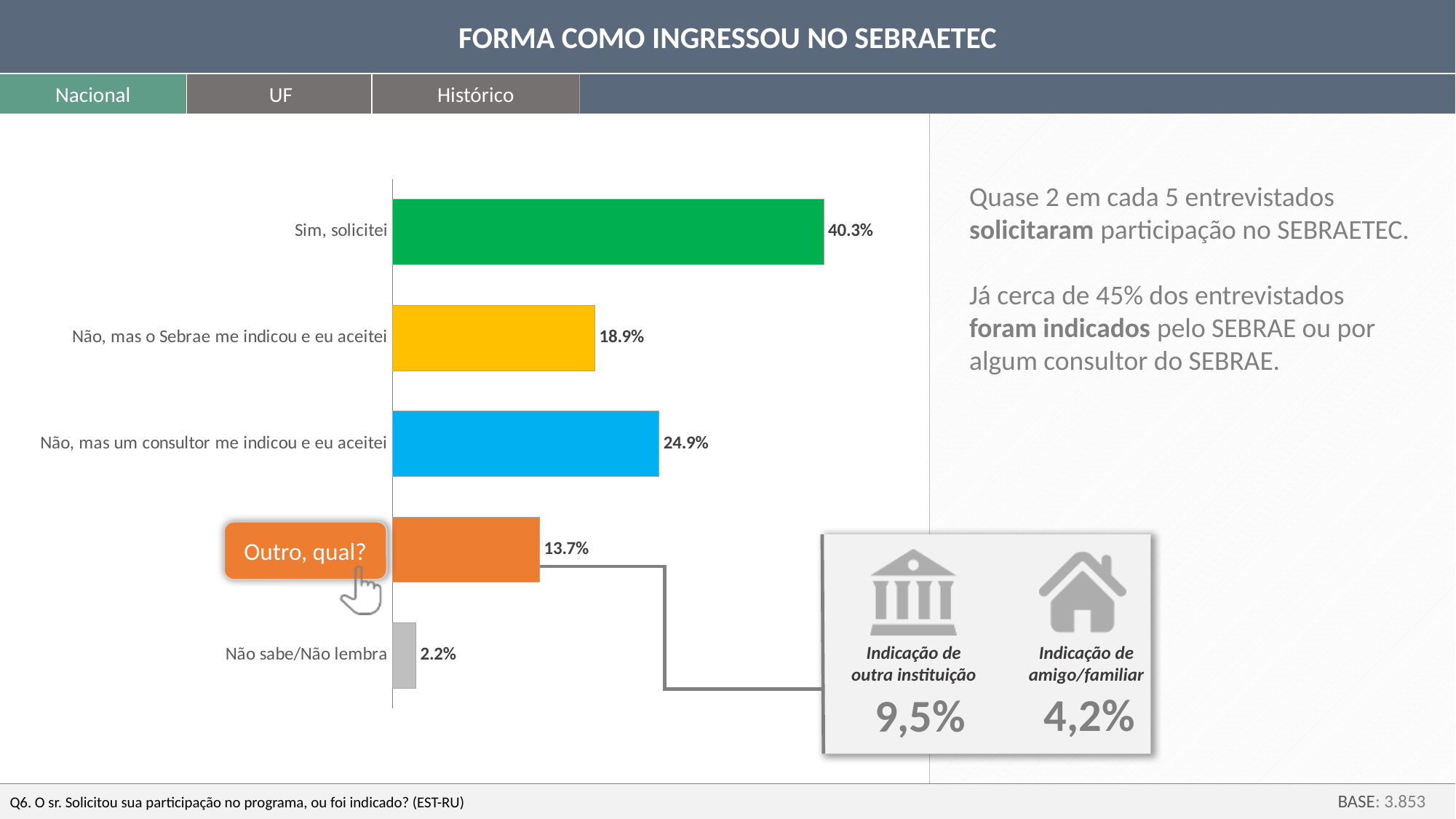
What is the value for "Não, mas o Sebrae me indicou e eu aceitei"? 18.9% What is the difference between "Sim, solicitei" and "Não, mas um consultor me indicou e eu aceitei"? 15.4% Which is larger: "Não, mas o Sebrae me indicou e eu aceitei" or "Não, mas um consultor me indicou e eu aceitei"? Não, mas um consultor me indicou e eu aceitei What kind of chart is shown on the slide? Bar chart How many categories does the bar chart show? 5 What is the value for "Não sabe/Não lembra"? 2.2% What is the value for "Outro, qual?"? 13.7% What is the title of the slide? FORMA COMO INGRESSOU NO SEBRAETEC Which category has the lowest value? Não sabe/Não lembra Which category has the highest value? Sim, solicitei What is the value for "Sim, solicitei"? 40.3% What is the value for "Não, mas um consultor me indicou e eu aceitei"? 24.9%